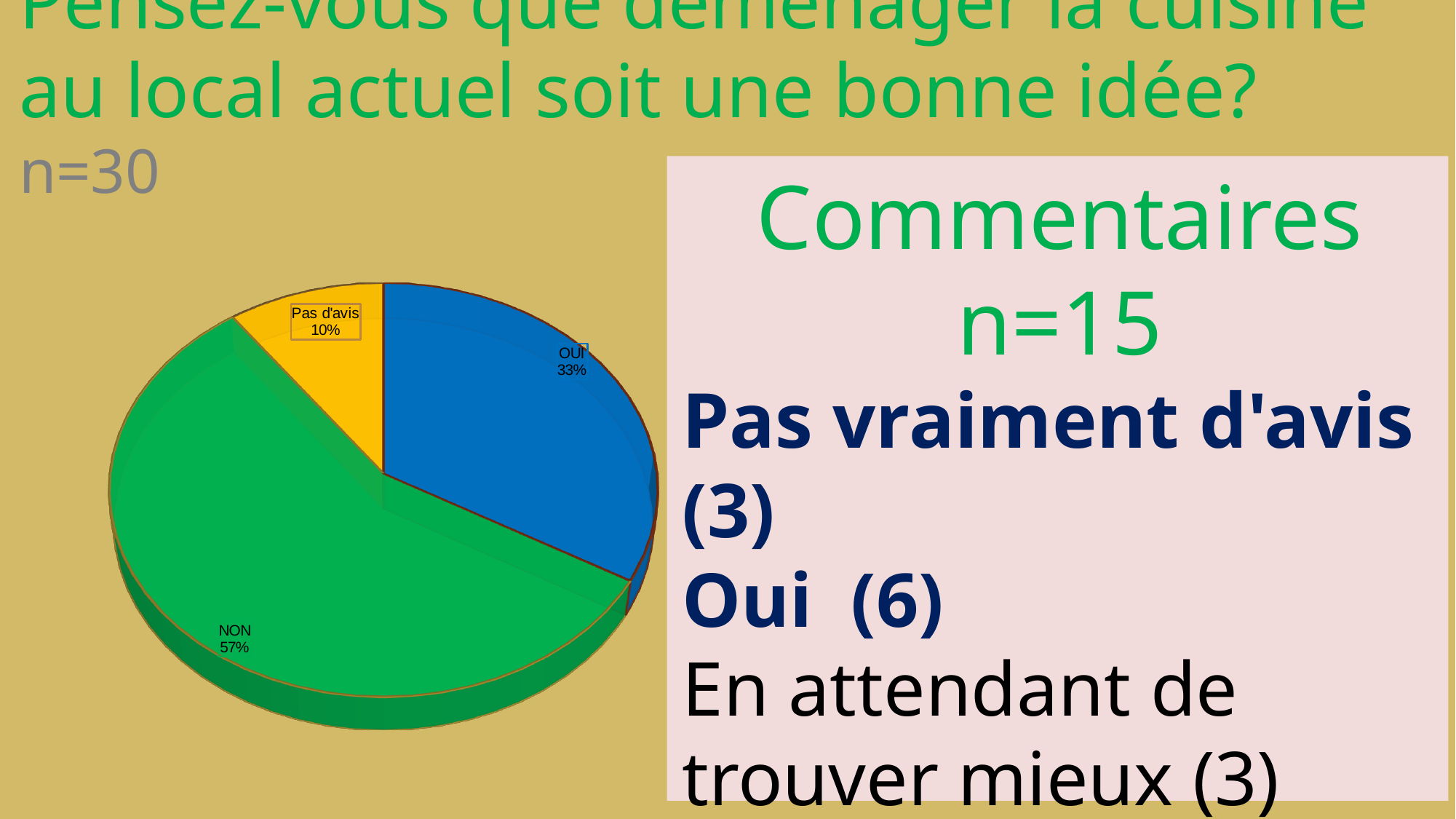
What colour is the NON slice of the pie chart? green What is the difference in percentage points between the NON and OUI slices? 24 What percentage of the pie is labelled NON? 57% Which slice is larger, OUI or Pas d'avis? OUI What sample size (n) is shown next to the pie chart's question? n=30 Which slice of the pie chart is the largest? NON Which slice of the pie chart is the smallest? Pas d'avis What share of the pie do the OUI and Pas d'avis slices make up together? 43% What percentage of the pie is labelled Pas d'avis? 10% What percentage of the pie is labelled OUI? 33% How many slices does the pie chart have? 3 What kind of chart is shown on the slide? pie chart